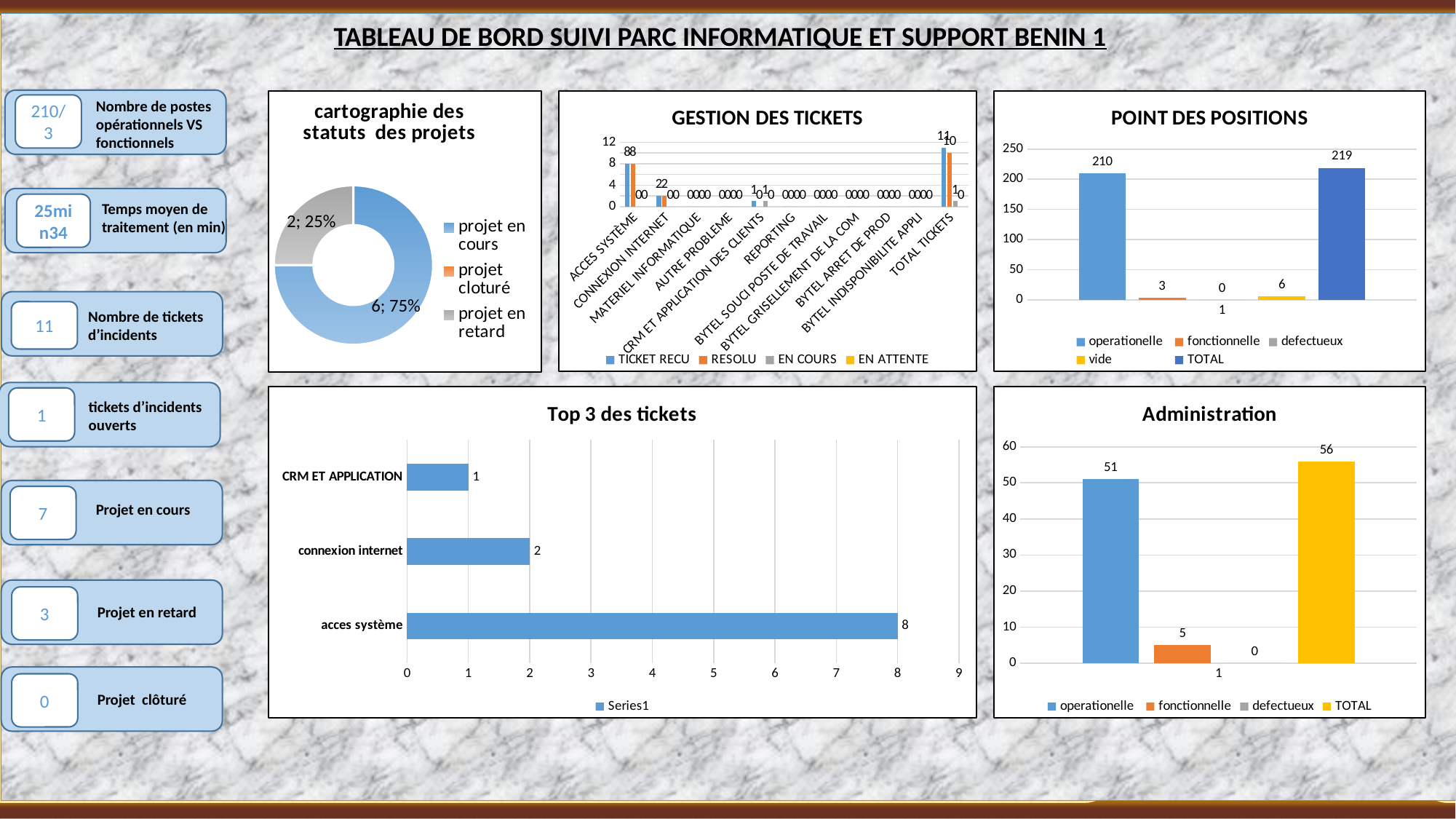
What kind of chart is 'Top 3 des tickets'? bar chart In the 'Top 3 des tickets' chart, what is the value for acces système? 8 In the 'POINT DES POSITIONS' chart, what is the value for operationelle? 210 In the 'cartographie des statuts des projets' chart, what share of the doughnut is projet en cours? 75% In the 'Administration' chart, which is larger, operationelle or fonctionnelle? operationelle In the 'Administration' chart, what is the difference between TOTAL and operationelle? 5 How many series does the legend of the 'POINT DES POSITIONS' chart list? 5 In the 'Top 3 des tickets' chart, what is the difference between acces système and connexion internet? 6 In the 'GESTION DES TICKETS' chart, what is the TICKET RECU value for TOTAL TICKETS? 11 In the 'Top 3 des tickets' chart, which category has the lowest value? CRM ET APPLICATION In the 'Administration' chart, what is the value for fonctionnelle? 5 In the 'POINT DES POSITIONS' chart, what is the value for TOTAL? 219